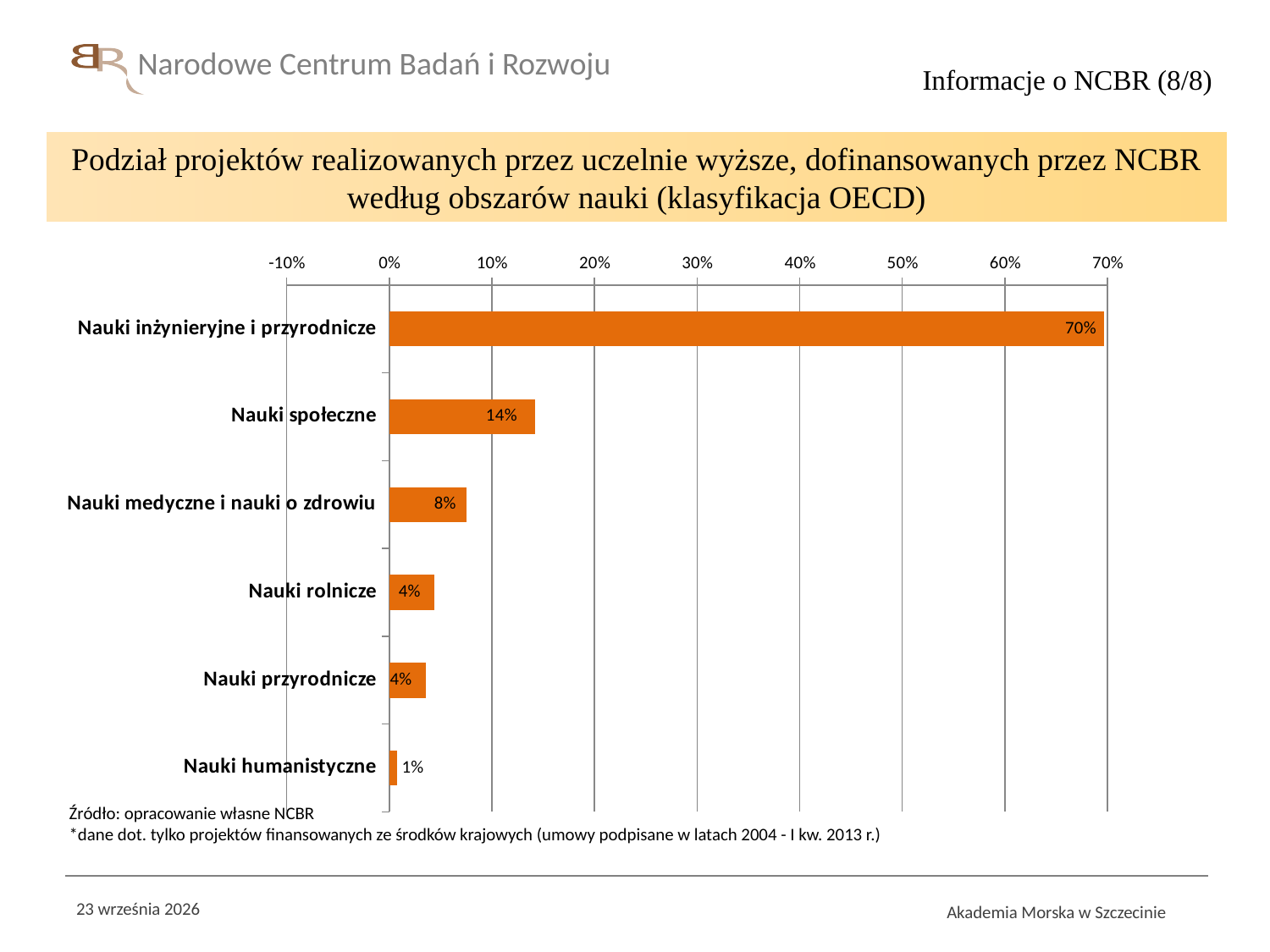
What is the value for Nauki inżynieryjne i przyrodnicze? 70% What kind of chart is shown on the slide? bar chart How many categories are shown in the chart? 6 Which is larger, the value for Nauki społeczne or the value for Nauki medyczne i nauki o zdrowiu? Nauki społeczne What is the source given below the chart? Źródło: opracowanie własne NCBR What is the value for Nauki humanistyczne? 1% What is the value for Nauki społeczne? 14% Which category has the highest value? Nauki inżynieryjne i przyrodnicze Which category has the lowest value? Nauki humanistyczne What is the value for Nauki medyczne i nauki o zdrowiu? 8% What is the difference between the values for Nauki inżynieryjne i przyrodnicze and Nauki społeczne? 56% Is the value for Nauki inżynieryjne i przyrodnicze greater or less than 60%? greater